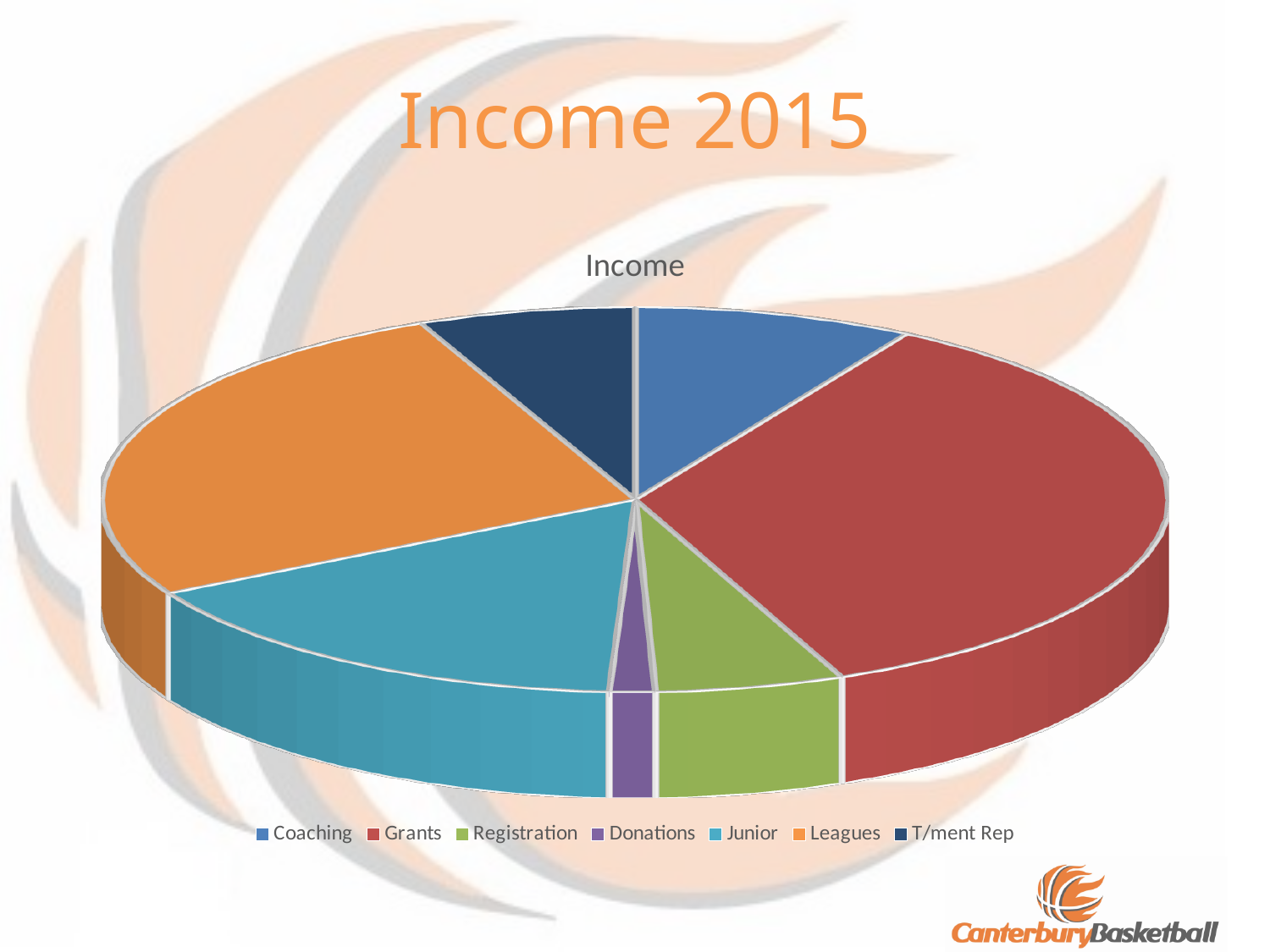
Which slice is larger, Junior or Donations? Junior Which slice is larger, Grants or Leagues? Grants What is the title shown above the pie chart? Income What kind of chart is shown on the slide? Pie chart Which slice is larger, Registration or Grants? Grants How many categories does the pie chart's legend list? 7 What colour is the Grants slice in the pie chart? Red Which category has the smallest slice of the pie? Donations Which category has the largest slice of the pie? Grants